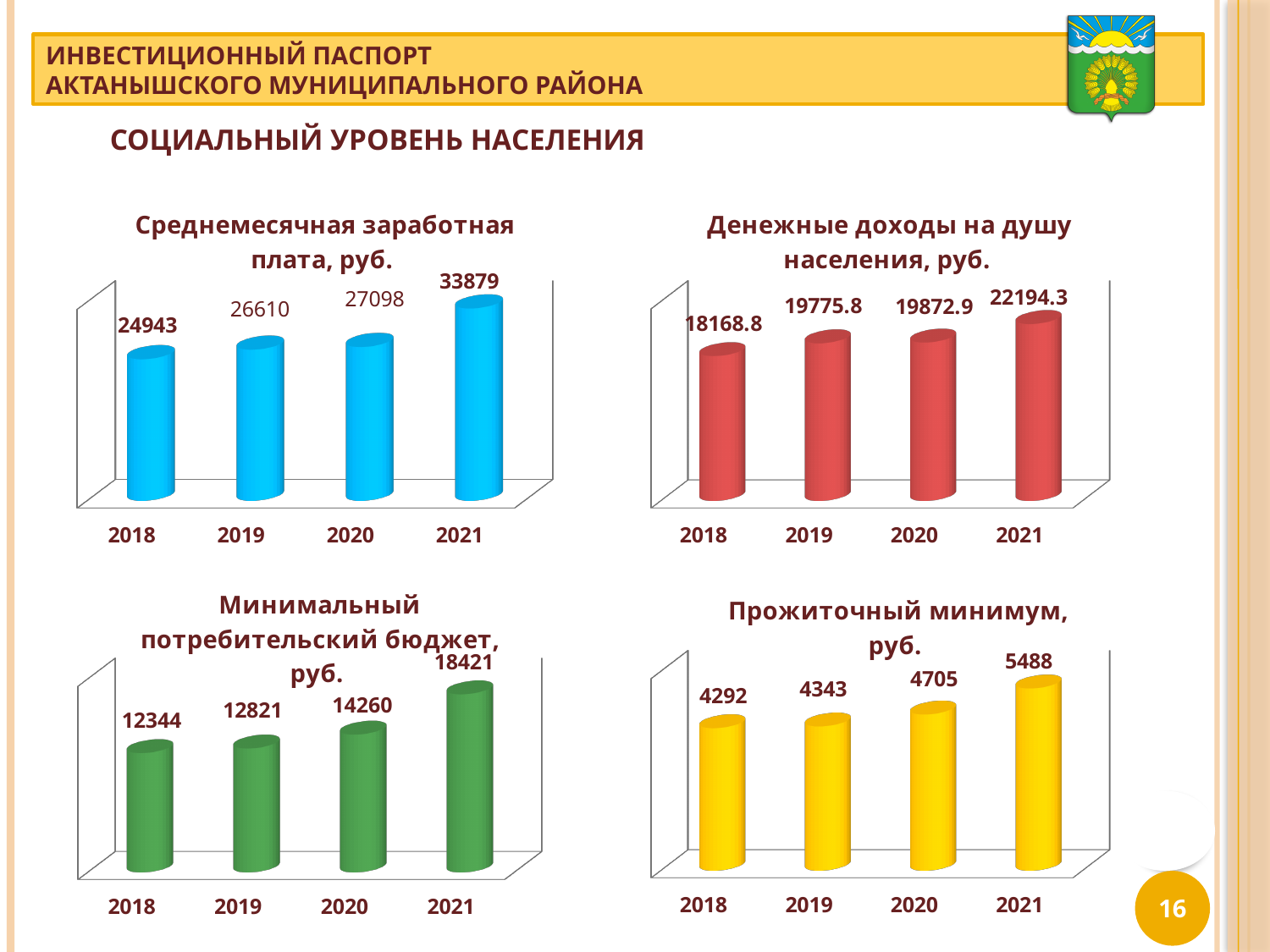
In the bottom-right chart (Прожиточный минимум, руб.), which year has the highest value? 2021 In the bottom-left chart (Минимальный потребительский бюджет, руб.), which is larger: the value for 2019 or the value for 2021? 2021 In the top-left chart (Среднемесячная заработная плата, руб.), what is the difference between the 2021 and 2018 values? 8936 How many years are shown on the x axis of the bottom-right chart (Прожиточный минимум, руб.)? 4 In the bottom-left chart (Минимальный потребительский бюджет, руб.), do the values rise or fall from 2018 to 2021? rise In the top-right chart (Денежные доходы на душу населения, руб.), what is the difference between the 2021 and 2018 values? 4025.5 In the top-right chart (Денежные доходы на душу населения, руб.), what is the value for 2018? 18168.8 In the bottom-left chart (Минимальный потребительский бюджет, руб.), what is the value for 2020? 14260 In the bottom-right chart (Прожиточный минимум, руб.), what is the value for 2019? 4343 In the top-left chart (Среднемесячная заработная плата, руб.), what is the value for 2021? 33879 What kind of chart is the top-right chart (Денежные доходы на душу населения, руб.)? bar chart In the top-left chart (Среднемесячная заработная плата, руб.), which year has the lowest value? 2018